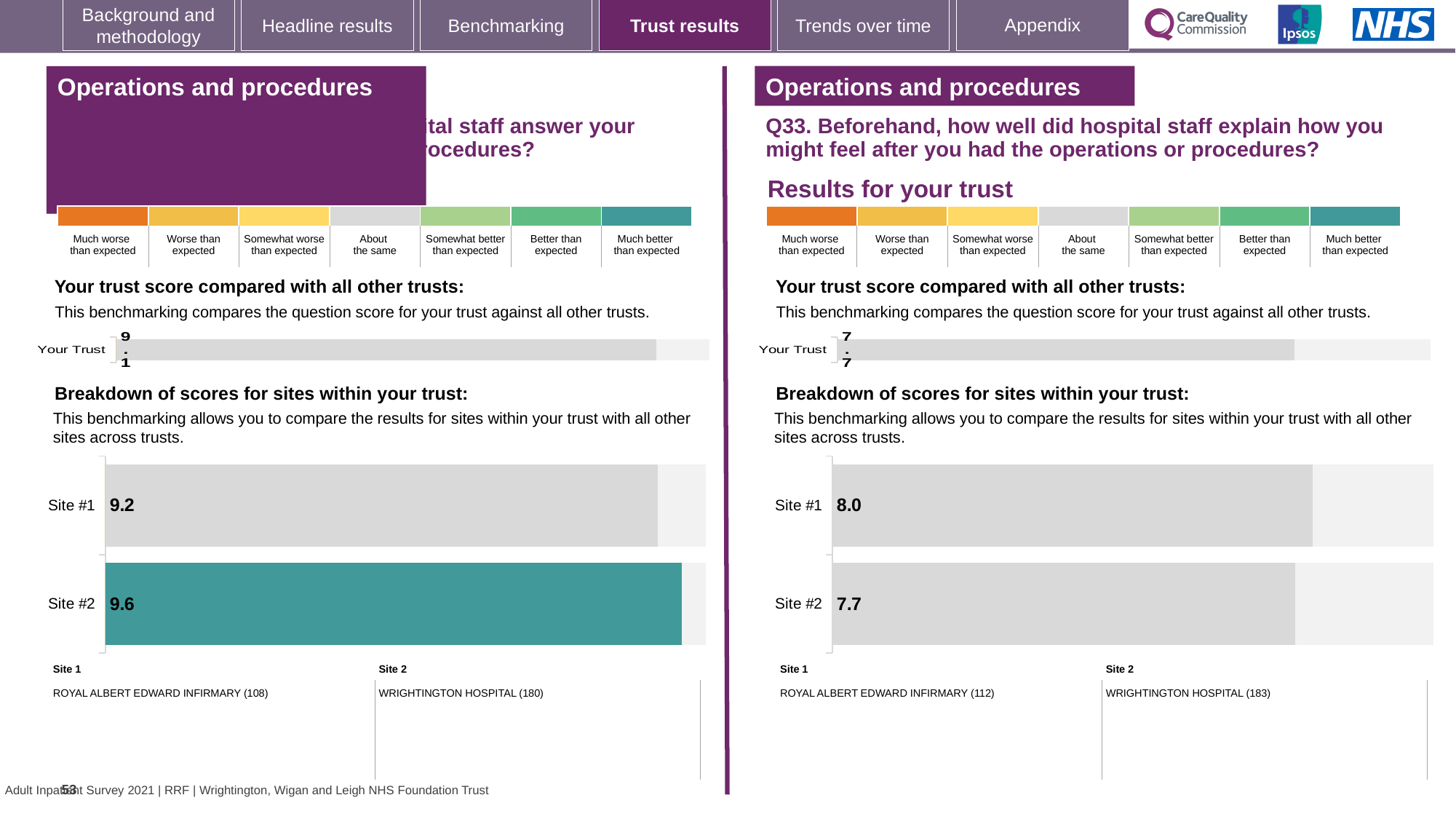
On the right-hand (Q33) site breakdown chart, what is the difference between the Site #1 and Site #2 scores? 0.3 On the left-hand 'Breakdown of scores for sites within your trust' chart, what is the score for Site #2? 9.6 On the right-hand (Q33) site breakdown chart, which site has the lower score? Site #2 What type of chart is used for the site breakdown on the left-hand side of the slide? Bar chart How many sites are shown on the right-hand (Q33) site breakdown chart? 2 On the right-hand (Q33) 'Your trust score compared with all other trusts' chart, what is the score for Your Trust? 7.7 On the left-hand site breakdown chart, what is the difference between the Site #2 and Site #1 scores? 0.4 On the left-hand 'Your trust score compared with all other trusts' chart, what is the score for Your Trust? 9.1 On the left-hand site breakdown chart, which site has the higher score? Site #2 On the right-hand (Q33) 'Breakdown of scores for sites within your trust' chart, what is the score for Site #1? 8.0 On the right-hand (Q33) 'Breakdown of scores for sites within your trust' chart, what is the score for Site #2? 7.7 On the left-hand 'Breakdown of scores for sites within your trust' chart, what is the score for Site #1? 9.2